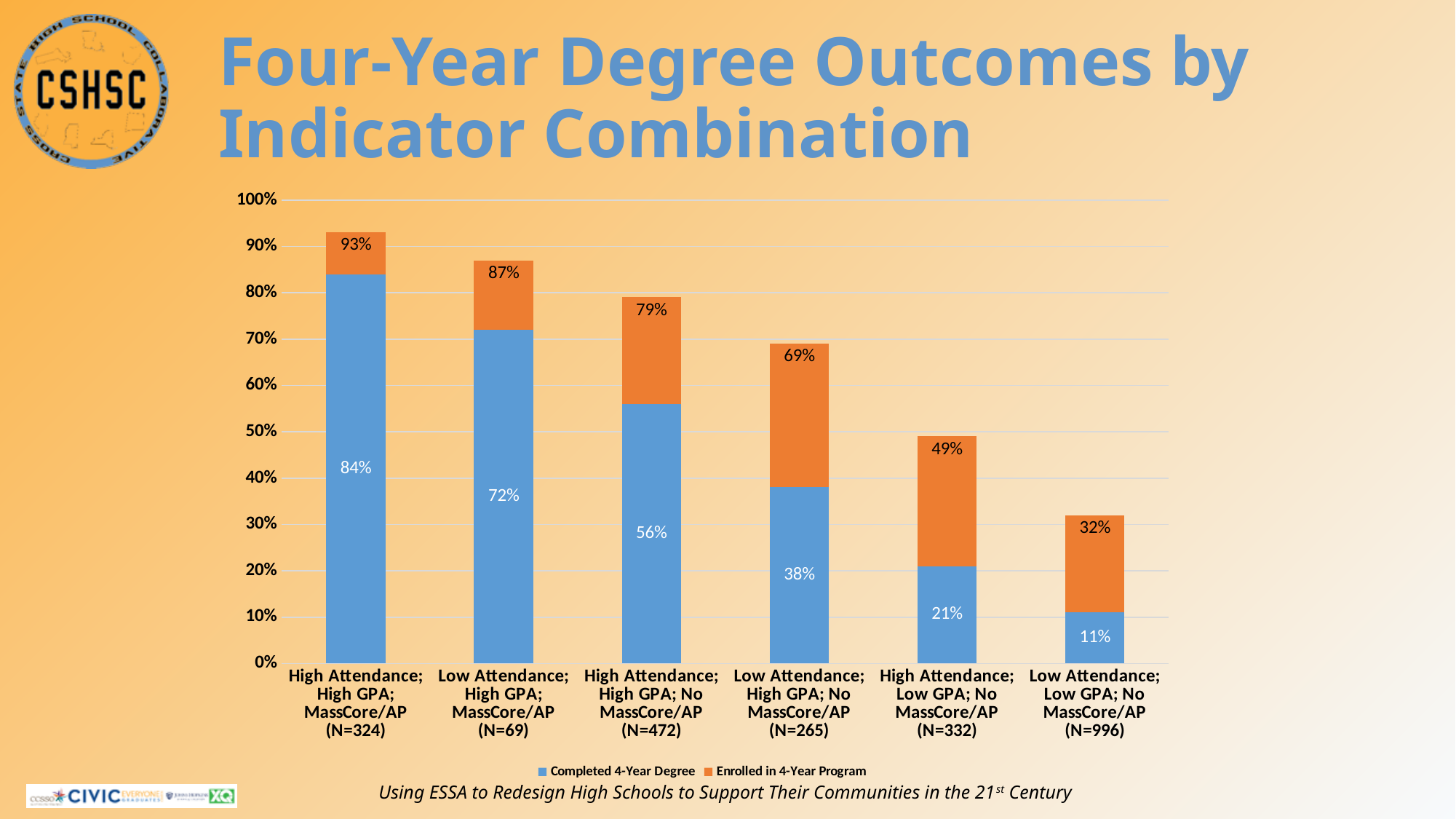
Which group has a higher Completed 4-Year Degree percentage: Low Attendance; High GPA; No MassCore/AP (N=265) or High Attendance; Low GPA; No MassCore/AP (N=332)? Low Attendance; High GPA; No MassCore/AP (N=265) What is the Completed 4-Year Degree value for the High Attendance; High GPA; No MassCore/AP (N=472) group? 56% Which indicator combination has the highest Completed 4-Year Degree percentage? High Attendance; High GPA; MassCore/AP (N=324) What type of chart is shown on the slide? Stacked bar chart Which indicator combination has the lowest Completed 4-Year Degree percentage? Low Attendance; Low GPA; No MassCore/AP (N=996) What percentage of students with High Attendance; High GPA; MassCore/AP (N=324) completed a 4-year degree? 84% How many series does the legend list? 2 What is the total height of the stacked bar for High Attendance; Low GPA; No MassCore/AP (N=332)? 49% What is the total height (completed plus enrolled) of the stacked bar for Low Attendance; High GPA; No MassCore/AP (N=265)? 69% How many indicator combination categories are shown on the x axis? 6 What percentage of students with Low Attendance; Low GPA; No MassCore/AP (N=996) completed a 4-year degree? 11% What is the difference in Completed 4-Year Degree percentage between the High Attendance; High GPA; MassCore/AP group and the Low Attendance; High GPA; MassCore/AP group? 12%